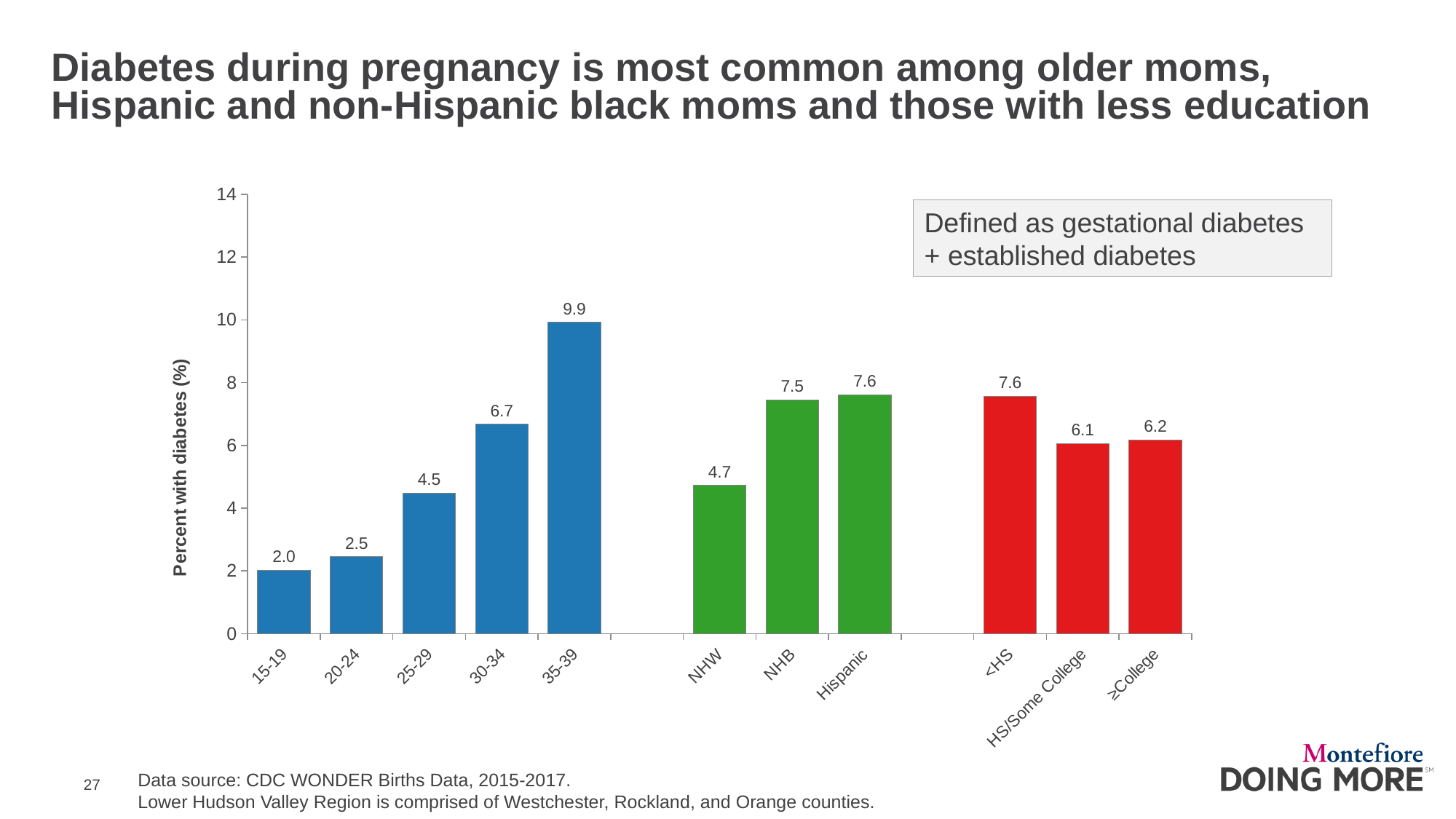
Which has a higher percent with diabetes, the 30-34 age group or the 25-29 age group? 30-34 What is the percent with diabetes for moms with HS/Some College education? 6.1 Which has a higher percent with diabetes, NHW or NHB? NHB What is the percent with diabetes for NHW moms? 4.7 What is the difference in percent with diabetes between the 35-39 and 15-19 age groups? 7.9 What kind of chart is shown on the slide? Bar chart Which category has the highest percent with diabetes? 35-39 What is the difference in percent with diabetes between <HS and ≥College? 1.4 How many categories are shown on the x axis? 11 What is the percent with diabetes for the 35-39 age group? 9.9 Do the values rise or fall across the age groups from 15-19 to 35-39? Rise Which category has the lowest percent with diabetes? 15-19